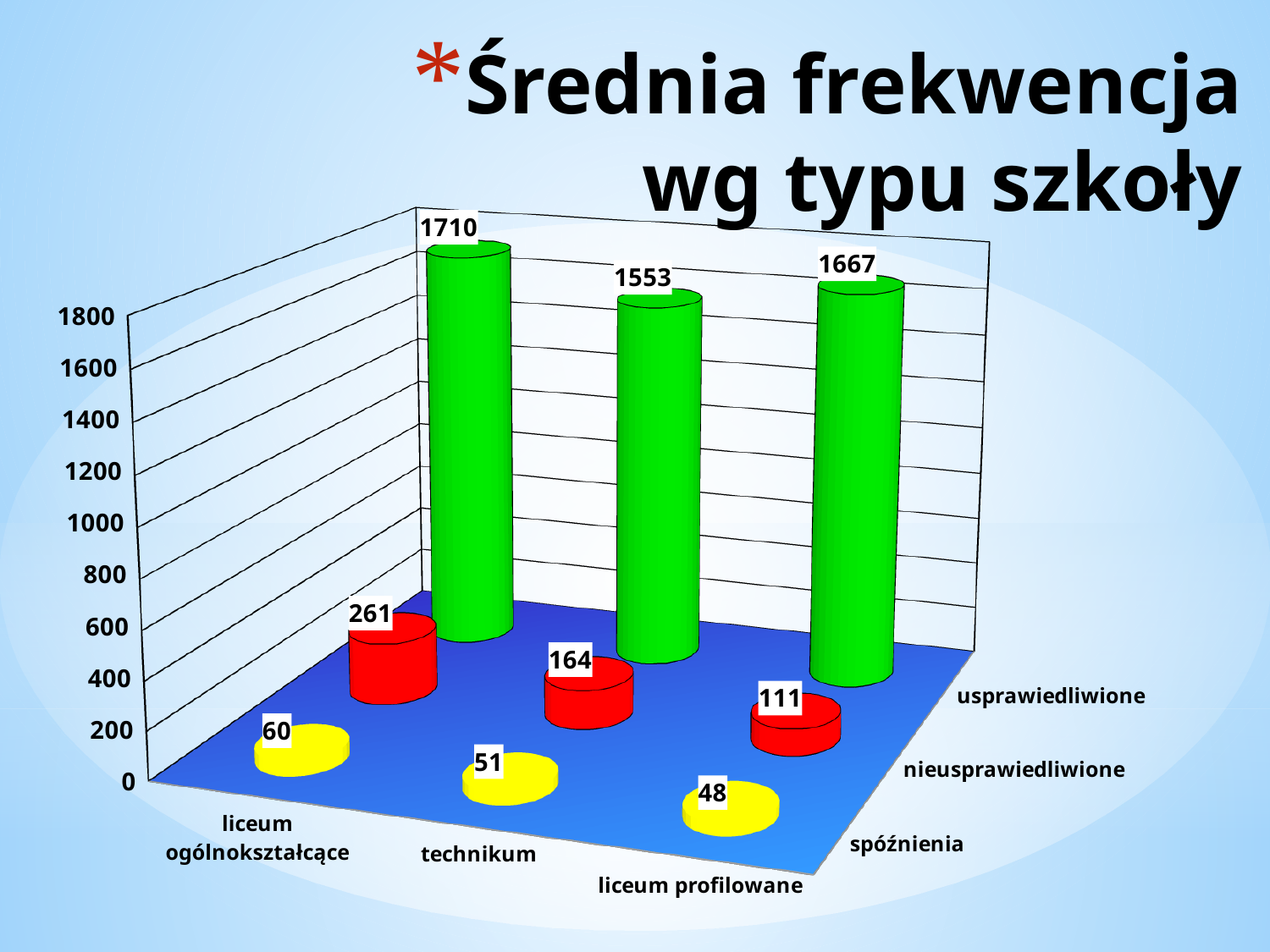
Which school type has the highest value for usprawiedliwione? liceum ogólnokształcące Which is larger: the nieusprawiedliwione value for liceum ogólnokształcące or for liceum profilowane? liceum ogólnokształcące What is the value for nieusprawiedliwione for technikum? 164 What is the value for usprawiedliwione for liceum ogólnokształcące? 1710 How many data series (usprawiedliwione, nieusprawiedliwione, spóźnienia) does the chart show? 3 Is the usprawiedliwione value for liceum profilowane greater or less than 1600? greater What is the value for spóźnienia for liceum profilowane? 48 Which school type has the lowest value for nieusprawiedliwione? liceum profilowane What is the difference between the usprawiedliwione values for liceum ogólnokształcące and technikum? 157 What kind of chart is shown on the slide? bar chart What colour are the bars for the usprawiedliwione series? green How many school types are shown on the chart? 3